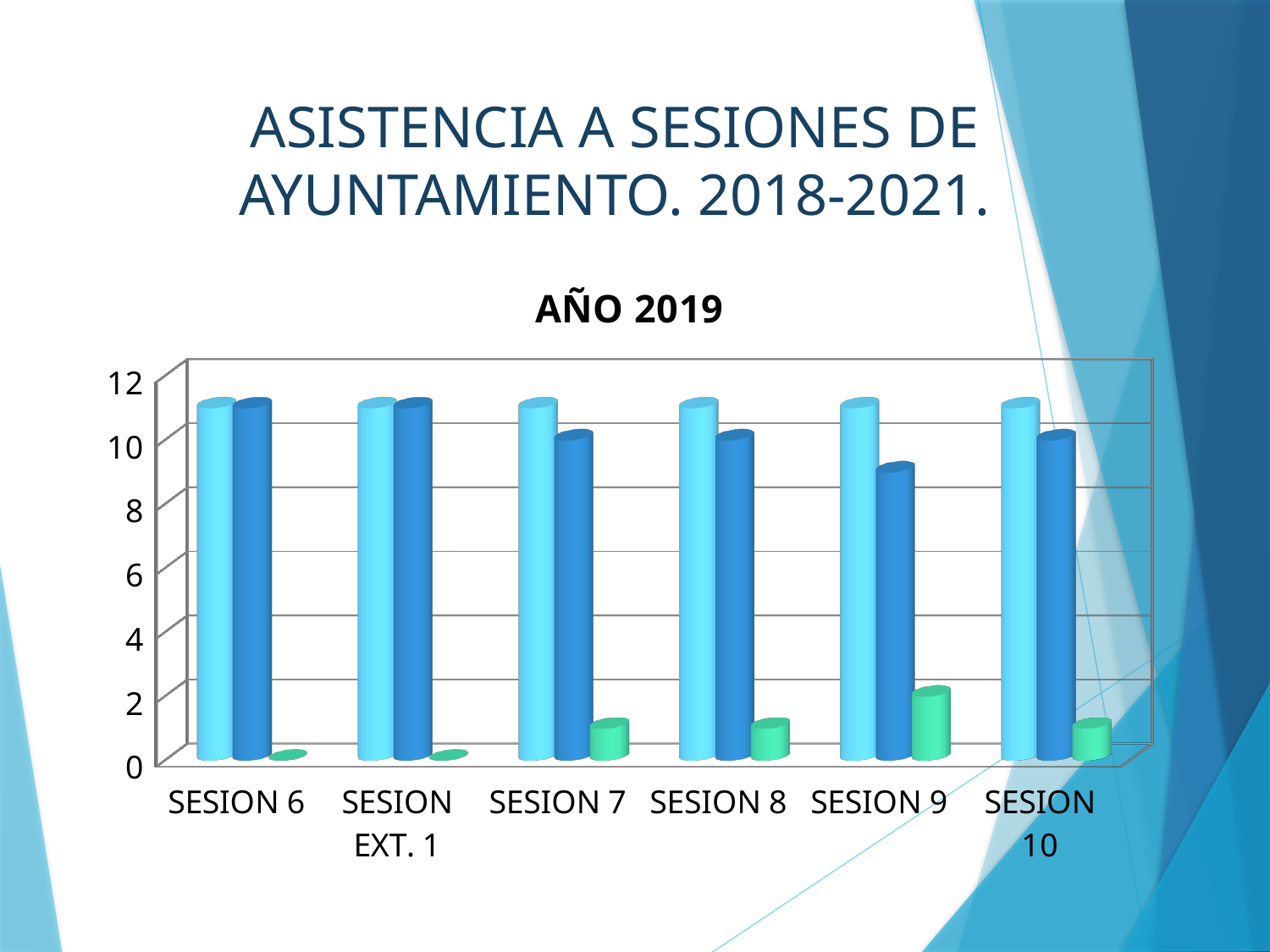
Which is larger, the green bar for SESION 9 or the green bar for SESION 7? SESION 9 How many categories are shown on the x axis of the chart? 6 Which category has the highest green bar? SESION 9 Is the value of the green bar for SESION 7 greater or less than 2? less Is the value of the green bar for SESION 9 greater or less than 4? less Which is larger, the dark blue bar for SESION 6 or the dark blue bar for SESION 9? SESION 6 What is the title of the chart? AÑO 2019 Is the value of the dark blue bar for SESION 9 greater or less than 10? less What kind of chart is shown on the slide? bar chart How many bars are plotted for each category in the chart? 3 Which category has the lowest dark blue bar? SESION 9